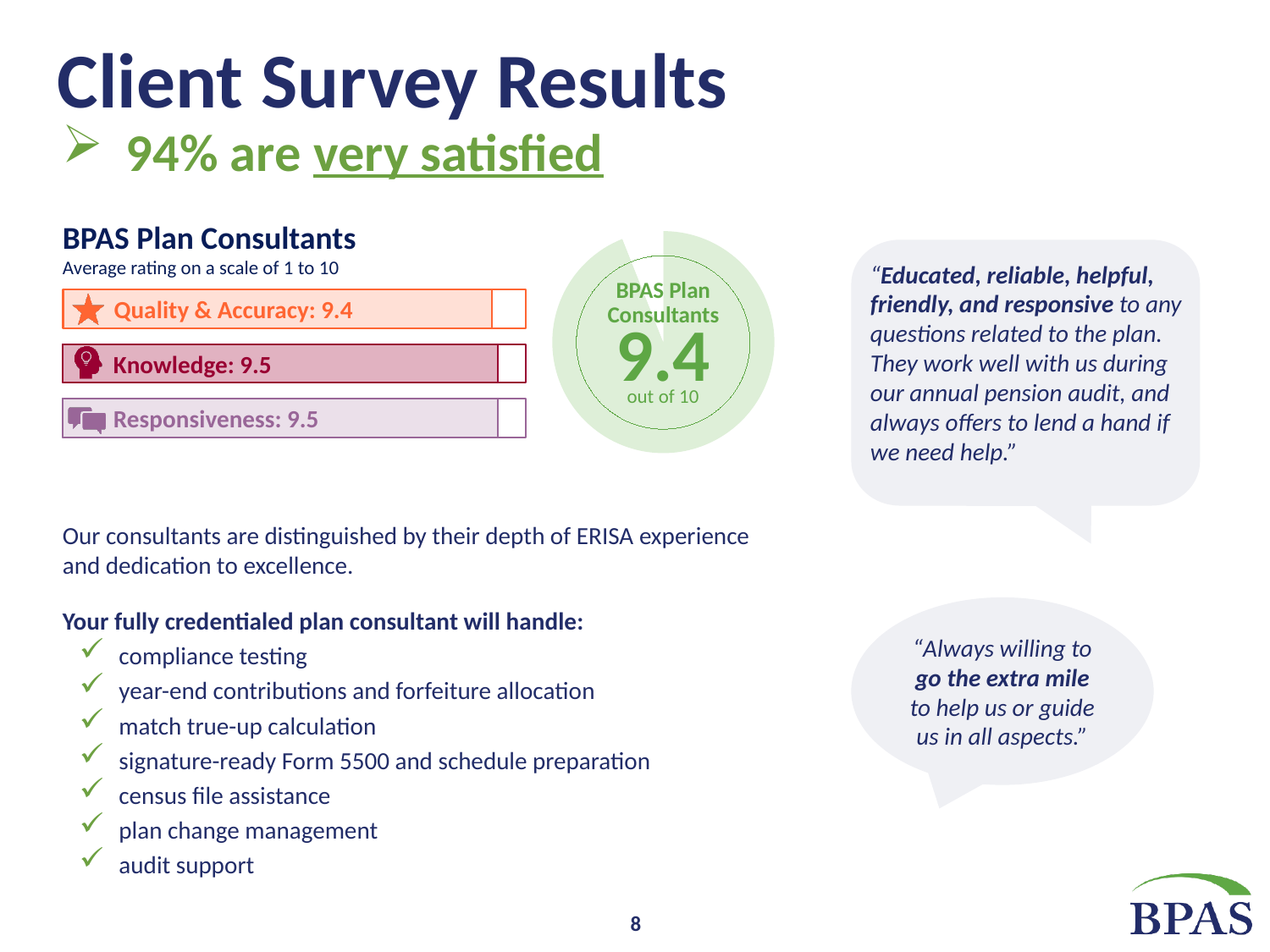
In the bar chart under 'BPAS Plan Consultants', what is the rating for Knowledge? 9.5 In the bar chart under 'BPAS Plan Consultants', which is higher: the rating for Knowledge or for Quality & Accuracy? Knowledge According to the text above the bar chart, on what scale are the average ratings given? A scale of 1 to 10 What overall rating is shown in the green circular chart for BPAS Plan Consultants? 9.4 What kind of chart is the green circular chart showing the 9.4 rating? Donut chart What is the title above the bar chart of ratings? BPAS Plan Consultants In the bar chart under 'BPAS Plan Consultants', what is the rating for Responsiveness? 9.5 In the bar chart under 'BPAS Plan Consultants', which category has the lowest rating? Quality & Accuracy In the bar chart under 'BPAS Plan Consultants', what is the rating for Quality & Accuracy? 9.4 What kind of chart is used to show the Quality & Accuracy, Knowledge and Responsiveness ratings? Bar chart In the bar chart under 'BPAS Plan Consultants', what is the difference between the Responsiveness rating and the Quality & Accuracy rating? 0.1 How many categories are shown in the bar chart under 'BPAS Plan Consultants'? 3